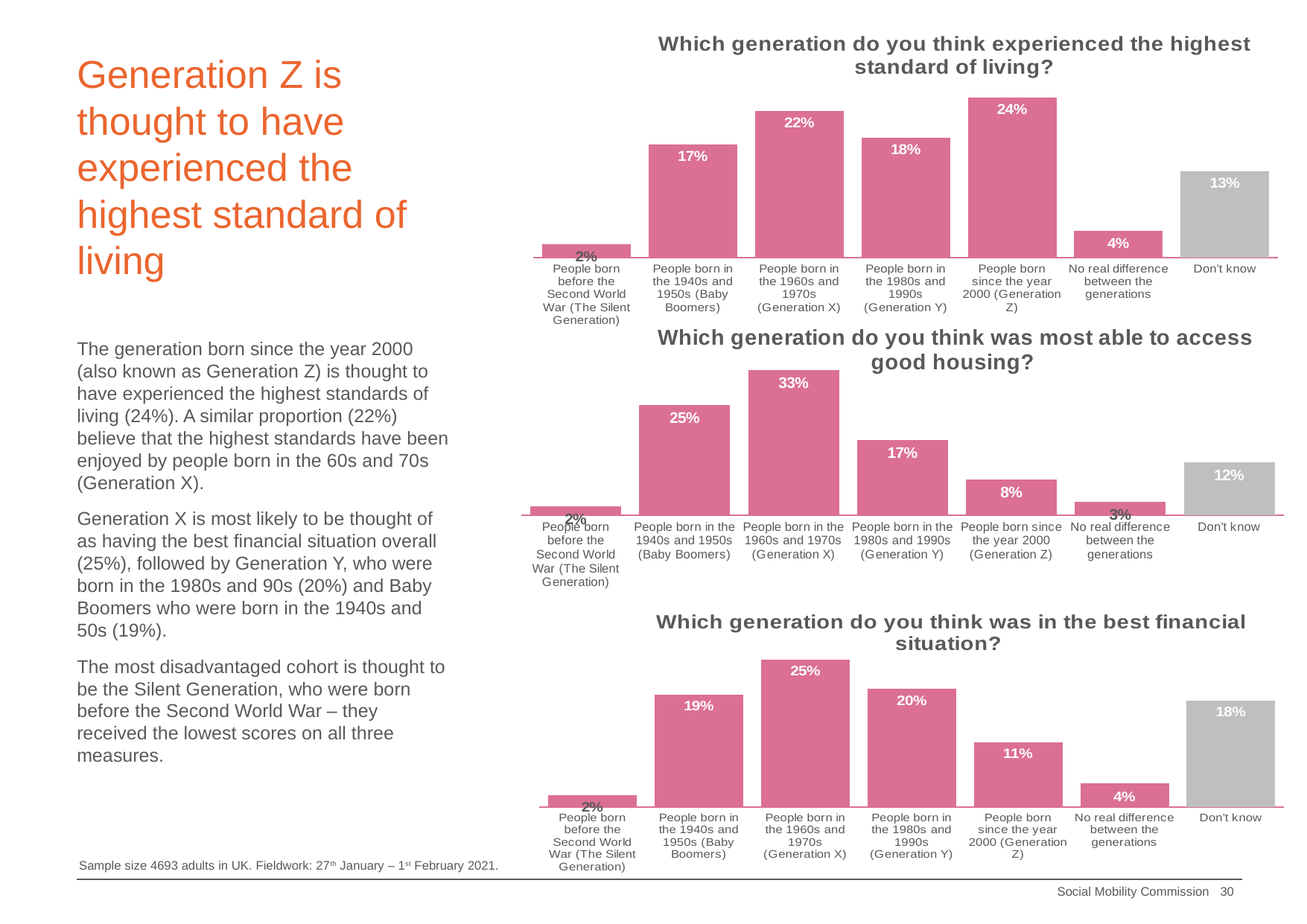
In the chart titled "Which generation do you think was most able to access good housing?", which category has the highest value? People born in the 1960s and 1970s (Generation X) In the chart titled "Which generation do you think was most able to access good housing?", which bar is coloured grey rather than pink? Don't know In the chart titled "Which generation do you think was in the best financial situation?", what is the value for Don't know? 18% In the chart titled "Which generation do you think was most able to access good housing?", what is the value for No real difference between the generations? 3% In the chart titled "Which generation do you think experienced the highest standard of living?", what is the value for People born since the year 2000 (Generation Z)? 24% In the chart titled "Which generation do you think was most able to access good housing?", what is the value for People born in the 1940s and 1950s (Baby Boomers)? 25% What type of chart is the chart titled "Which generation do you think experienced the highest standard of living?"? Bar chart In the chart titled "Which generation do you think was in the best financial situation?", what is the difference between the values for Generation X and Generation Z? 14% In the chart titled "Which generation do you think experienced the highest standard of living?", what is the difference between the values for Generation Z and Generation X? 2% How many categories are shown in the chart titled "Which generation do you think was in the best financial situation?"? 7 In the chart titled "Which generation do you think experienced the highest standard of living?", which category has the lowest value? People born before the Second World War (The Silent Generation) In the chart titled "Which generation do you think was in the best financial situation?", which is larger: the value for Generation Y or the value for Baby Boomers? Generation Y